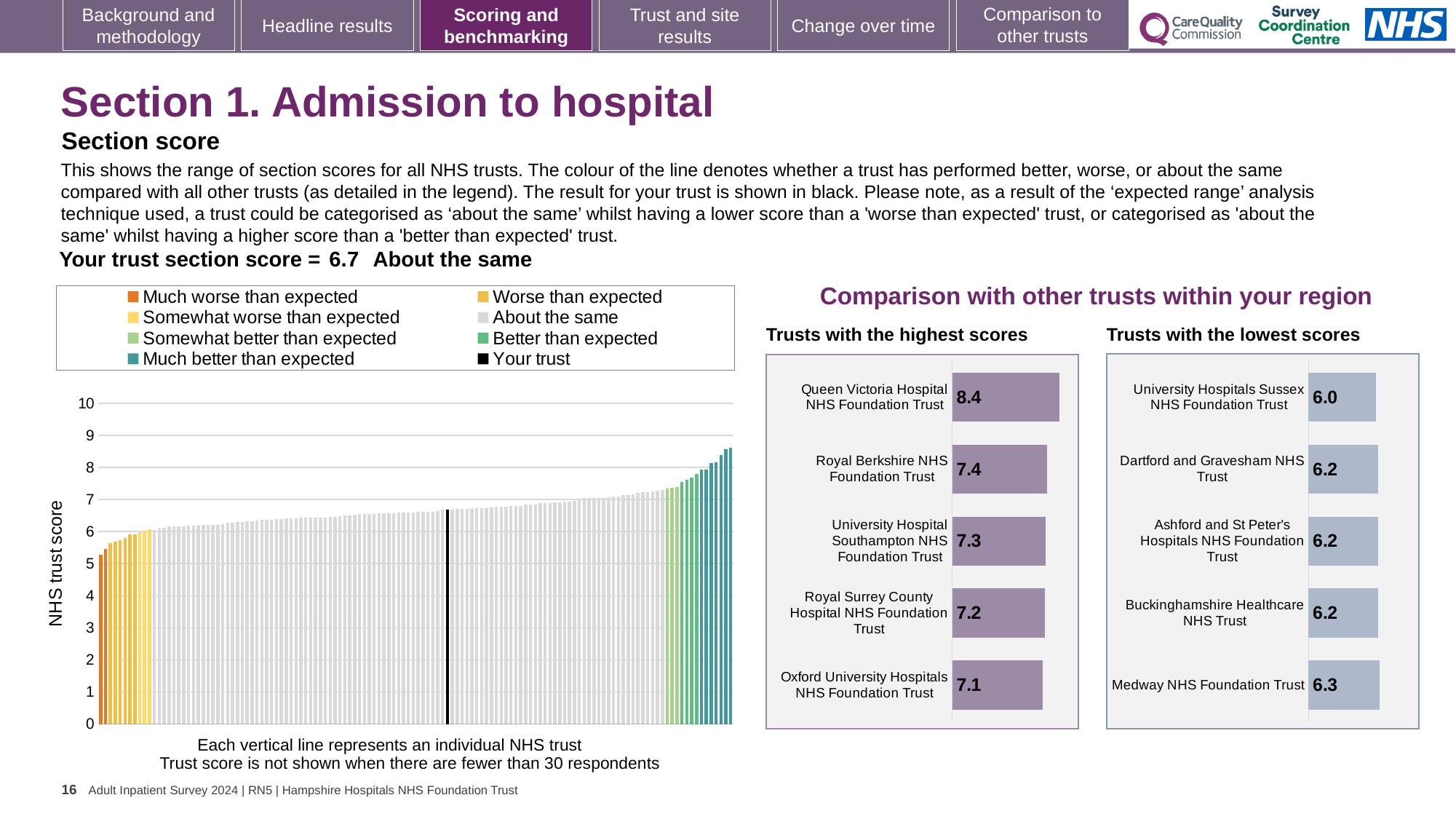
In the 'Trusts with the highest scores' chart, what is the score for Oxford University Hospitals NHS Foundation Trust? 7.1 In the 'Trusts with the lowest scores' chart, what is the score for Medway NHS Foundation Trust? 6.3 In the 'Trusts with the highest scores' chart, what is the score for Queen Victoria Hospital NHS Foundation Trust? 8.4 In the 'Trusts with the highest scores' chart, which trust has the highest score? Queen Victoria Hospital NHS Foundation Trust In the 'Trusts with the lowest scores' chart, which has the larger score: Medway NHS Foundation Trust or University Hospitals Sussex NHS Foundation Trust? Medway NHS Foundation Trust How many entries does the legend of the large chart on the left list? 8 How many trusts are shown in the 'Trusts with the highest scores' chart? 5 What kind of chart is the large chart on the left showing NHS trust scores? Bar chart In the 'Trusts with the lowest scores' chart, what is the score for University Hospitals Sussex NHS Foundation Trust? 6.0 In the 'Trusts with the highest scores' chart, what is the difference between the scores of Queen Victoria Hospital NHS Foundation Trust and Royal Berkshire NHS Foundation Trust? 1.0 In the 'Trusts with the lowest scores' chart, what is the difference between the scores of Medway NHS Foundation Trust and University Hospitals Sussex NHS Foundation Trust? 0.3 In the 'Trusts with the lowest scores' chart, which trust has the lowest score? University Hospitals Sussex NHS Foundation Trust